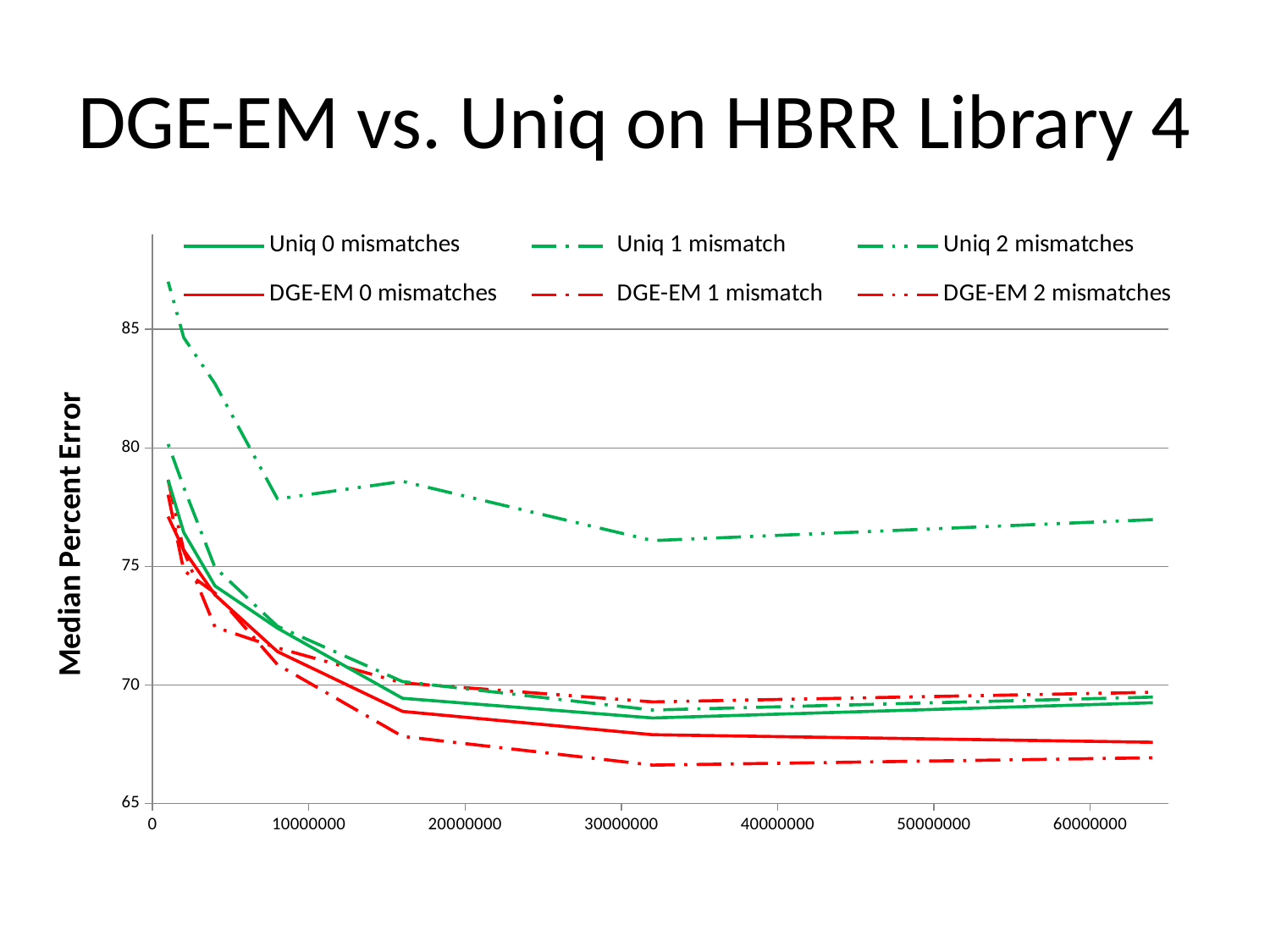
At the right end of the x axis, which series has the highest Median Percent Error? Uniq 2 mismatches Do the values for Uniq 2 mismatches rise or fall overall along the x axis? fall Is the value for DGE-EM 1 mismatch at the right end of the x axis greater or less than 70? less Do the values for DGE-EM 0 mismatches rise or fall overall along the x axis? fall Is the value for Uniq 2 mismatches at the right end of the x axis greater or less than 75? greater Is the value for DGE-EM 0 mismatches at the right end of the x axis greater or less than 70? less What is the label on the vertical axis? Median Percent Error How many series does the legend list? 6 What is the title of the chart? DGE-EM vs. Uniq on HBRR Library 4 At the right end of the x axis, which series has the lowest Median Percent Error? DGE-EM 1 mismatch What kind of chart is shown on the slide? line chart